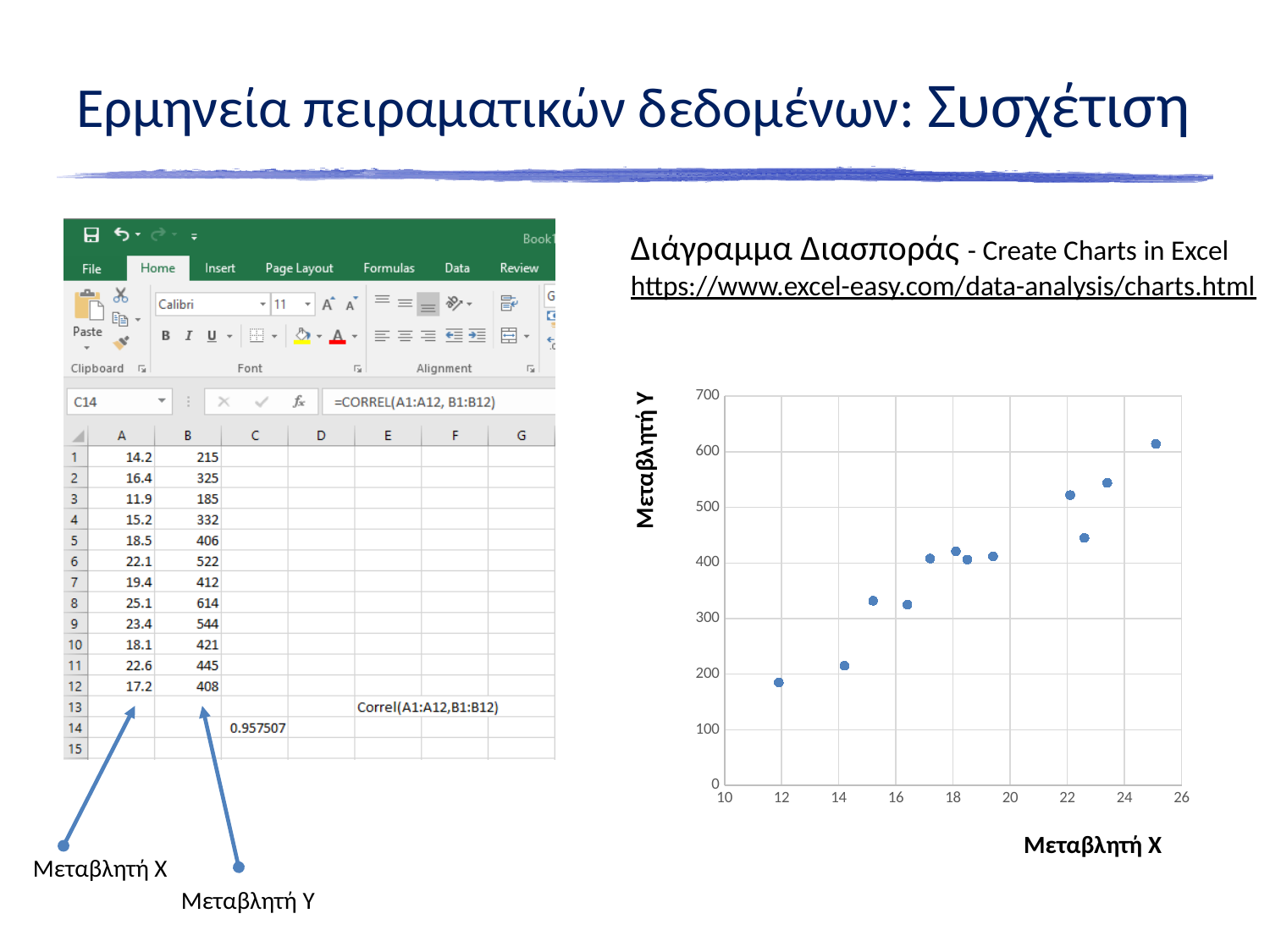
Do the Y values generally rise or fall as X increases along the x axis? rise What is the title of the horizontal axis of the chart? Μεταβλητή X What is the title of the vertical axis of the chart? Μεταβλητή Y Is the Y value of the point near X = 19.4 greater or less than 500? less Is the Y value of the leftmost point (near X = 12) greater or less than 200? less How many data points are plotted in the scatter chart? 12 Is the Y value of the point near X = 16 greater or less than 300? greater What kind of chart is shown on the slide? scatter chart Which point has the higher Y value: the one near X = 12 or the one near X = 25? the one near X = 25 Which point has the higher Y value: the one near X = 22.1 or the one near X = 22.6? the one near X = 22.1